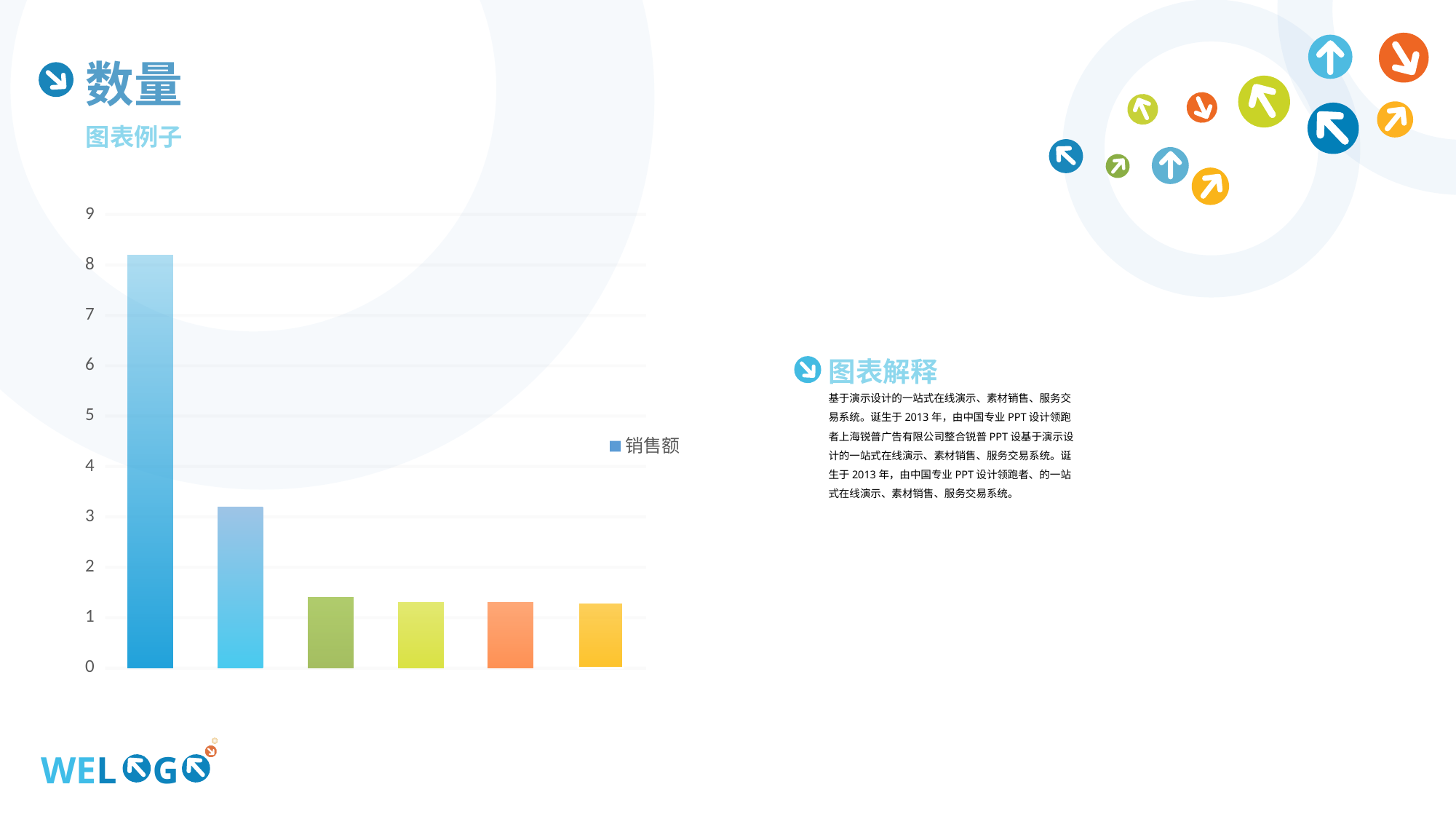
Is the value of the first (leftmost) bar greater or less than 7? greater Is the value of the second bar from the left greater or less than 2? greater How many series does the chart legend list? 1 Is the value of the second bar from the left greater or less than 4? less What is the highest value shown on the vertical axis? 9 What kind of chart is shown on the slide? bar chart Which bar is the tallest in the chart? the first (leftmost) bar What is the series name shown in the chart legend? 销售额 Do the bar values generally rise or fall from left to right? fall Which is larger, the first bar or the second bar from the left? the first bar How many bars are plotted in the chart? 6